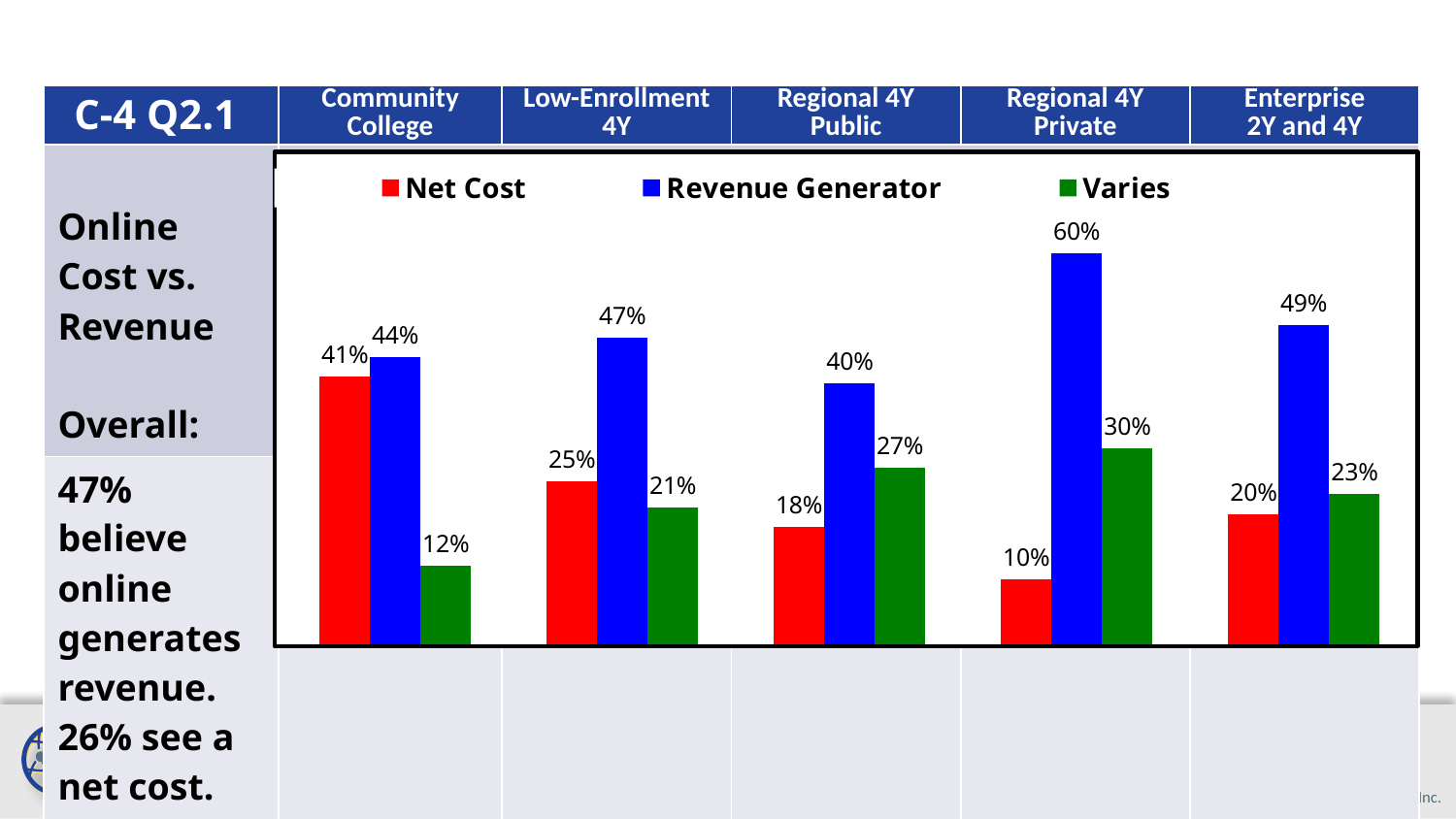
Which institution type has the lowest Varies value? Community College Which is larger for Enterprise 2Y and 4Y: the Net Cost value or the Varies value? Varies How many institution types are shown on the x axis? 5 What colour represents the Revenue Generator series? Blue Which institution type has the highest Revenue Generator value? Regional 4Y Private What is the Revenue Generator value for Regional 4Y Private? 60% What is the Varies value for Low-Enrollment 4Y? 21% How many series does the legend list? 3 What is the Net Cost value for Community College? 41% What is the difference between the Revenue Generator and Net Cost values for Regional 4Y Public? 22% What kind of chart is shown? Bar chart Which institution type has the lowest Net Cost value? Regional 4Y Private